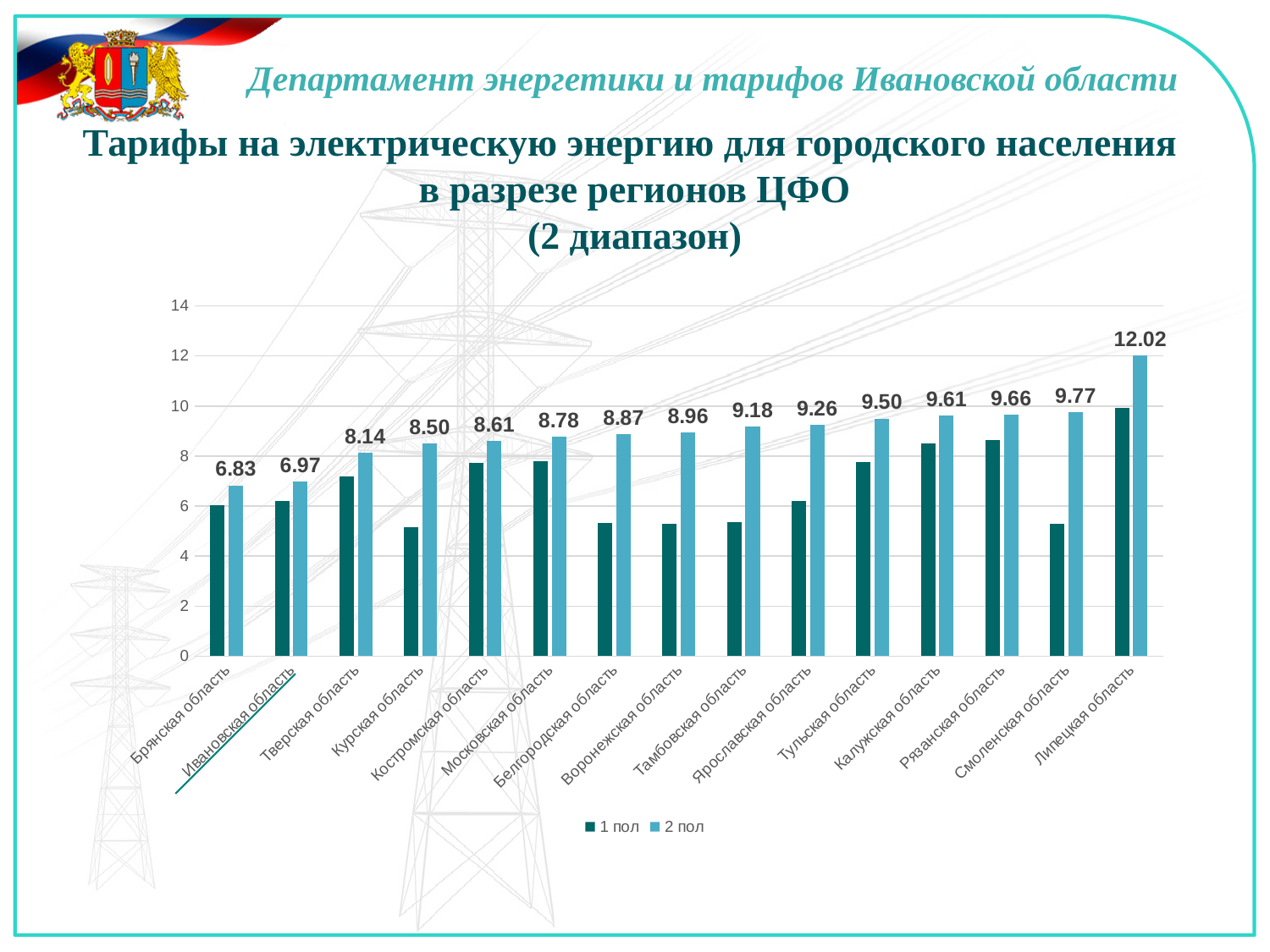
How many regions are shown on the x axis of the chart? 15 What kind of chart is shown on the slide? Bar chart Which region has the lowest "2 пол" value? Брянская область Which is larger: the "2 пол" value for Курская область or for Тульская область? Тульская область What is the value of the "2 пол" series for Липецкая область? 12.02 Which region has the highest "2 пол" value? Липецкая область How many series does the legend list? 2 What is the value of the "2 пол" series for Тамбовская область? 9.18 What is the value of the "2 пол" series for Ивановская область? 6.97 Is the "1 пол" value for Курская область greater or less than 6? less What is the difference between the "2 пол" values for Липецкая область and Ивановская область? 5.05 Is the "1 пол" value for Липецкая область greater or less than 8? greater